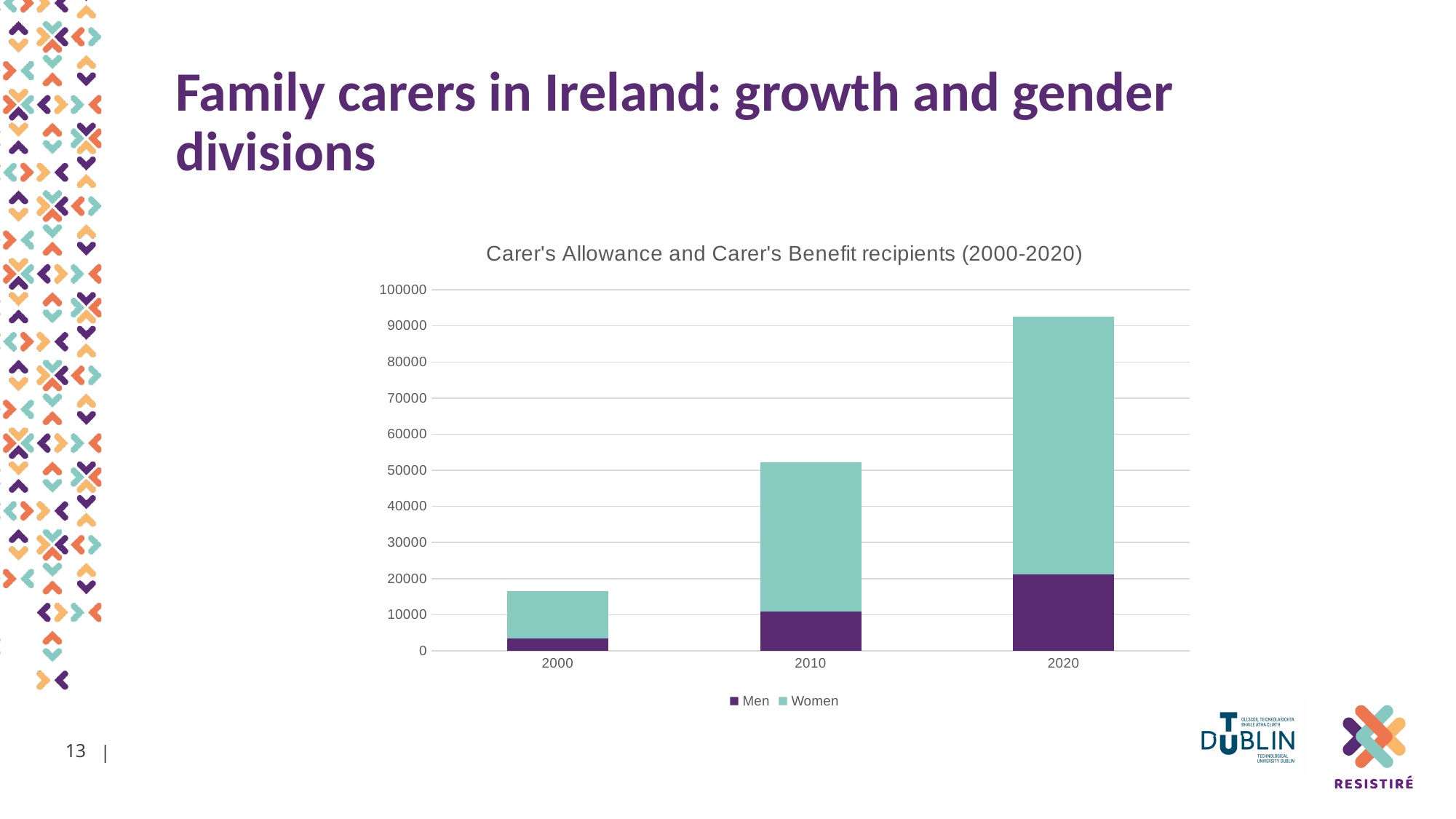
Which year has the lowest total number of recipients? 2000 In 2020, which series has the larger value, Men or Women? Women Which year has the highest total number of recipients? 2020 How many series does the chart's legend list? 2 Is the total number of recipients in 2010 greater or less than 50000? greater What kind of chart is shown on the slide? Stacked bar chart Is the total number of recipients in 2020 greater or less than 90000? greater What is the title of the chart? Carer's Allowance and Carer's Benefit recipients (2000-2020) Do the total recipient numbers rise or fall from 2000 to 2020? Rise Which colour represents the Women series in the chart? Teal (light green) How many years are shown on the x axis of the chart? 3